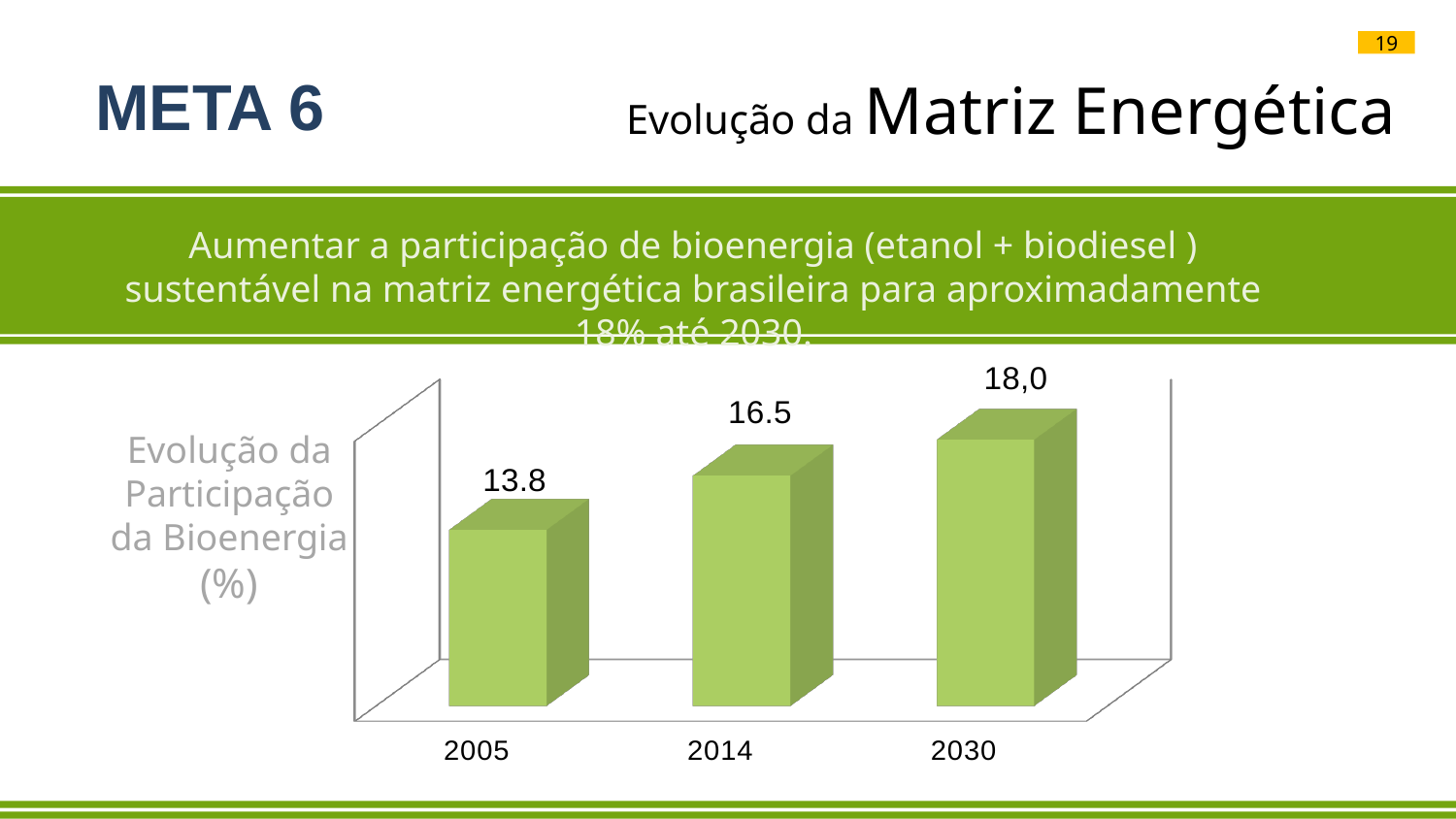
What is the difference between the values for 2030 and 2014? 1.5 Which year has the lowest value? 2005 What is the value shown for 2005? 13.8 How many years are shown on the x axis? 3 What is the difference between the values for 2014 and 2005? 2.7 Which is larger, the value for 2014 or the value for 2005? 2014 What is the difference between the values for 2030 and 2005? 4.2 Which year has the highest value? 2030 What is the value shown for 2014? 16.5 Do the values rise or fall from 2005 to 2030? Rise What kind of chart is shown on the slide? Bar chart What is the value shown for 2030? 18,0